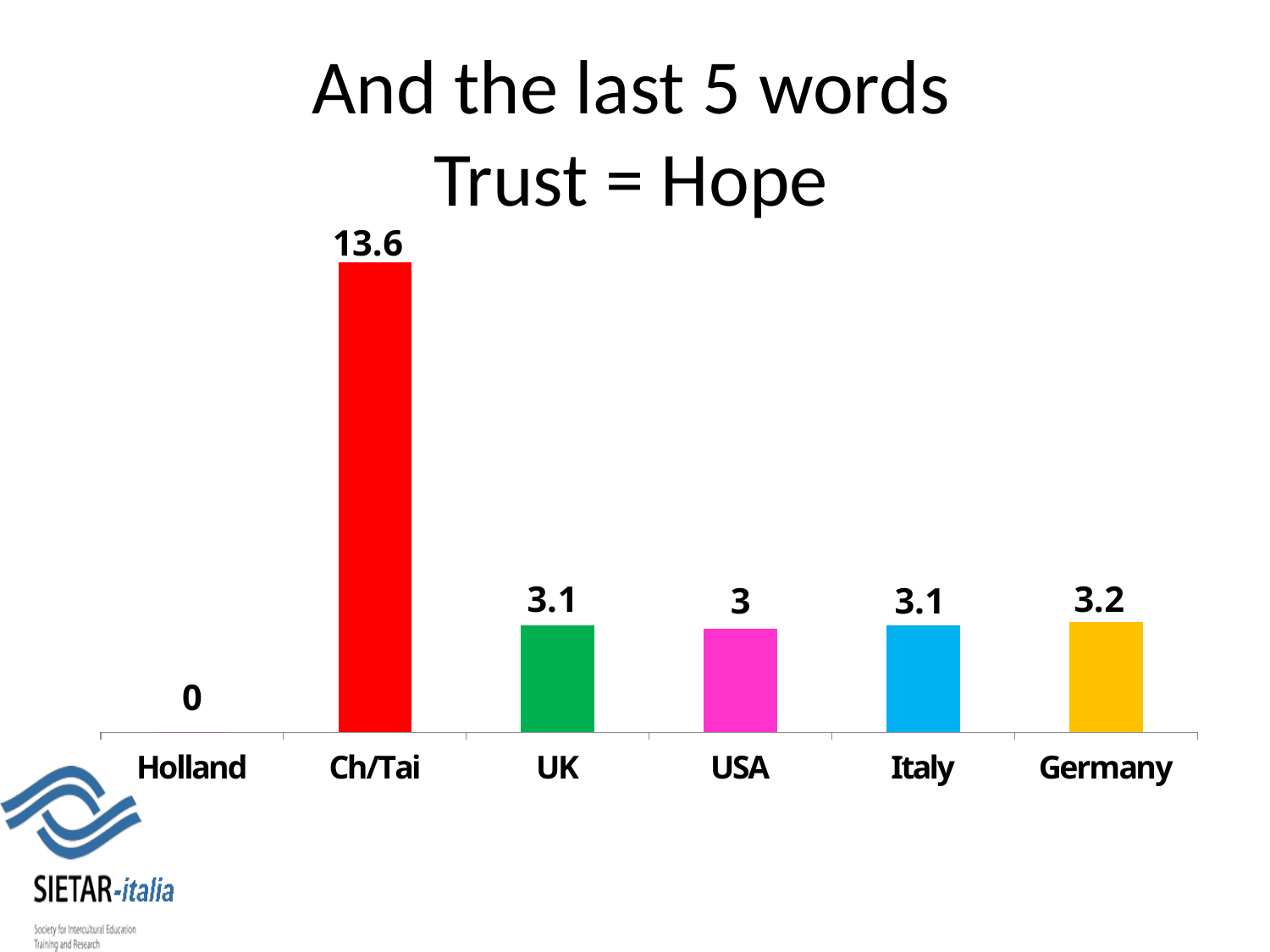
Which is larger, the value for Ch/Tai or the value for Italy? Ch/Tai What is the difference between the values for Ch/Tai and Germany? 10.4 What kind of chart is shown on the slide? Bar chart Which category has the lowest value? Holland What is the value for USA? 3 Which category has the highest value? Ch/Tai What is the difference between the values for UK and USA? 0.1 What is the value for Ch/Tai? 13.6 What is the value for Germany? 3.2 How many categories are shown on the x axis? 6 What is the value for Holland? 0 What colour is the bar for Ch/Tai? Red